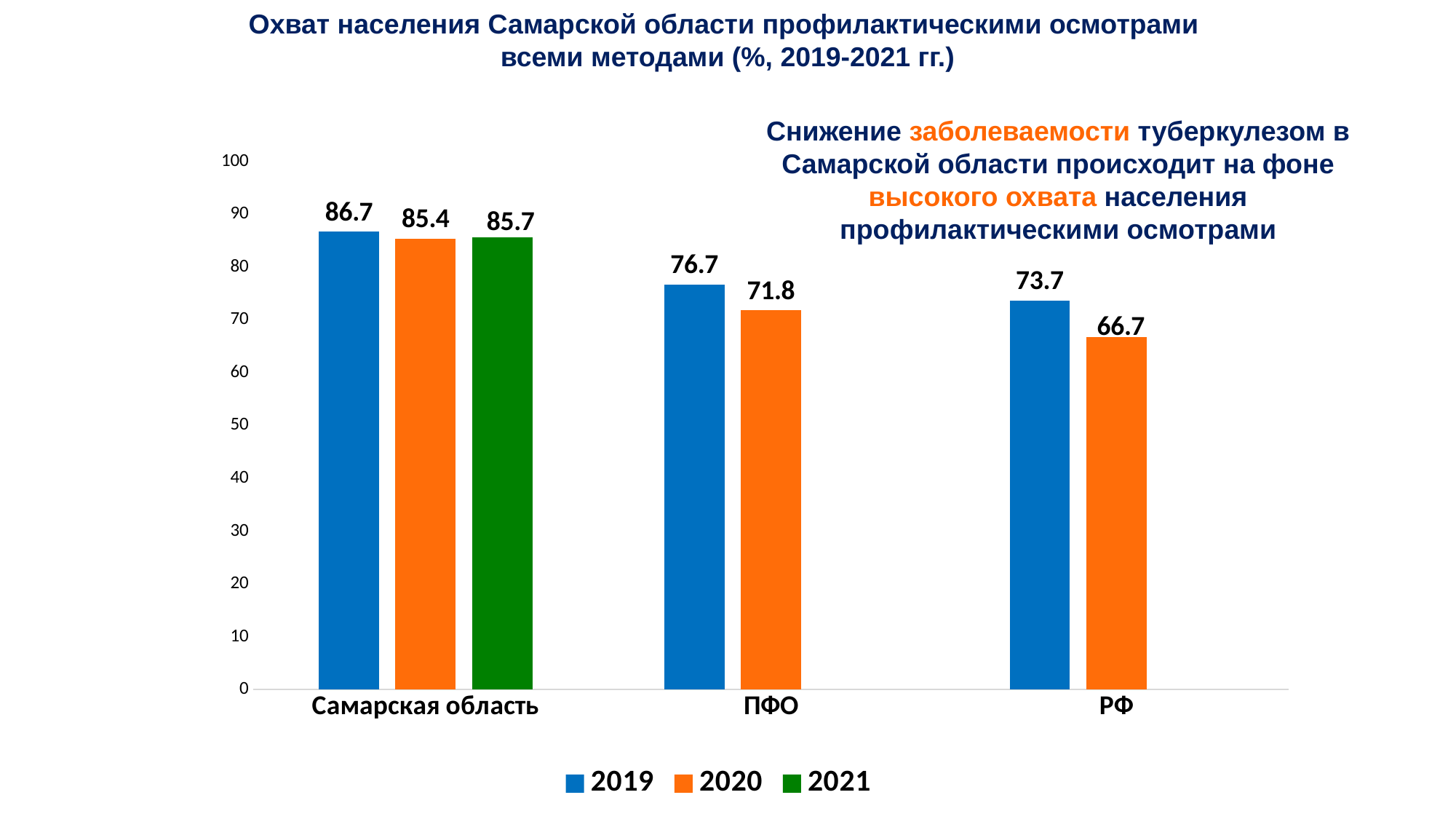
How many series does the legend list? 3 What kind of chart is shown on the slide? Bar chart How many categories are shown on the x axis? 3 What is the value for Самарская область in 2021? 85.7 Which colour represents the 2021 series in the legend? Green Which category has the lowest value in 2019? РФ What is the value for Самарская область in 2019? 86.7 What is the value for РФ in 2019? 73.7 Which category has the highest value in 2020? Самарская область What is the difference between the 2019 and 2020 values for РФ? 7 Which is larger: the 2019 value for ПФО or the 2019 value for РФ? ПФО What is the value for ПФО in 2020? 71.8